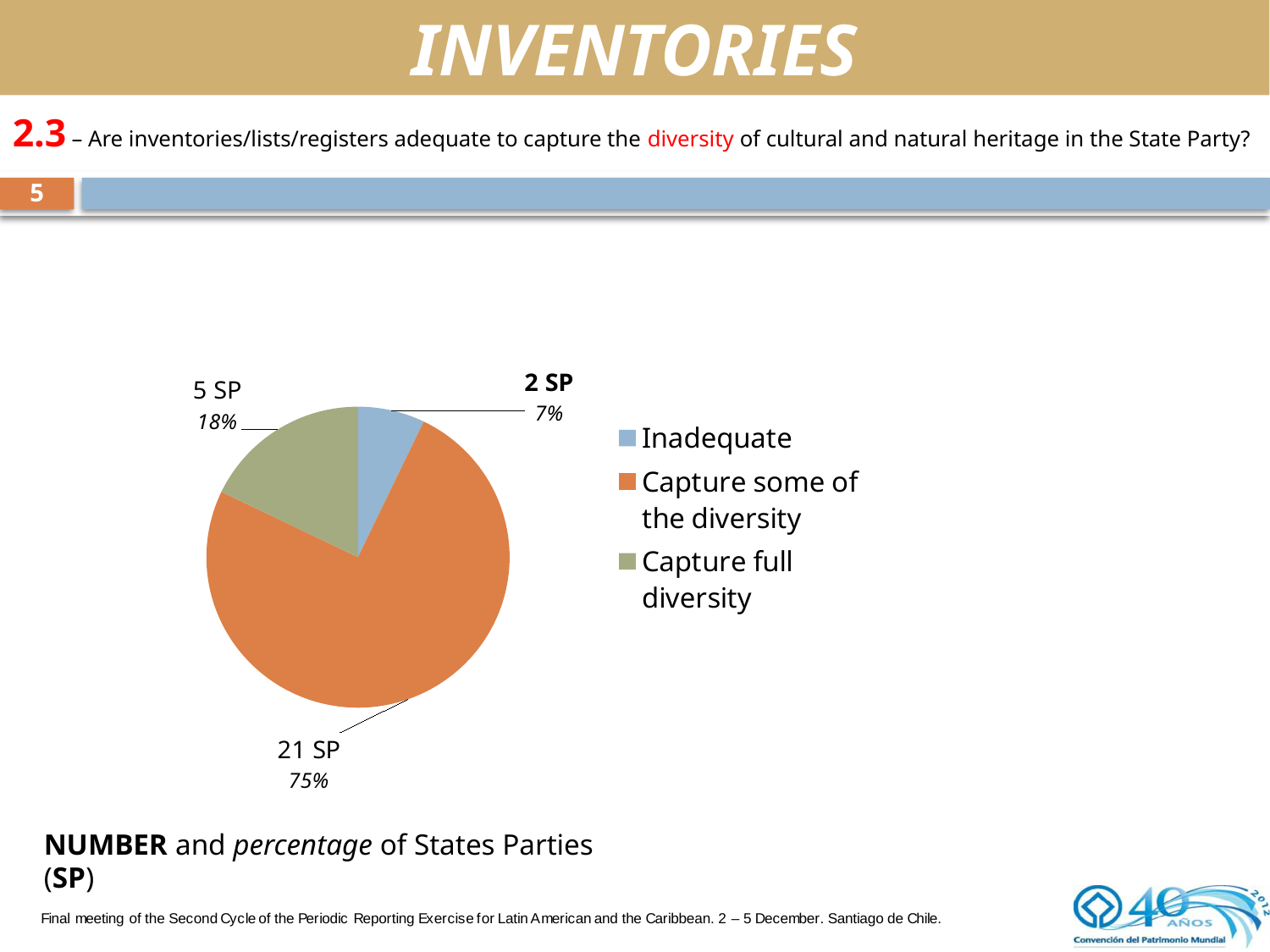
Which category has the smallest slice of the pie? Inadequate What is the total number of States Parties across all slices of the pie? 28 What colour is the 'Capture some of the diversity' slice? orange What percentage of States Parties 'Capture some of the diversity'? 75% How many States Parties 'Capture full diversity'? 5 SP Which is larger: the 'Capture full diversity' slice or the 'Inadequate' slice? Capture full diversity Which category has the largest slice of the pie? Capture some of the diversity What kind of chart is shown on the slide? pie chart How many States Parties are in the 'Inadequate' slice? 2 SP How many categories does the pie chart have? 3 What percentage of States Parties are in the 'Inadequate' category? 7% How many more States Parties 'Capture some of the diversity' than 'Capture full diversity'? 16